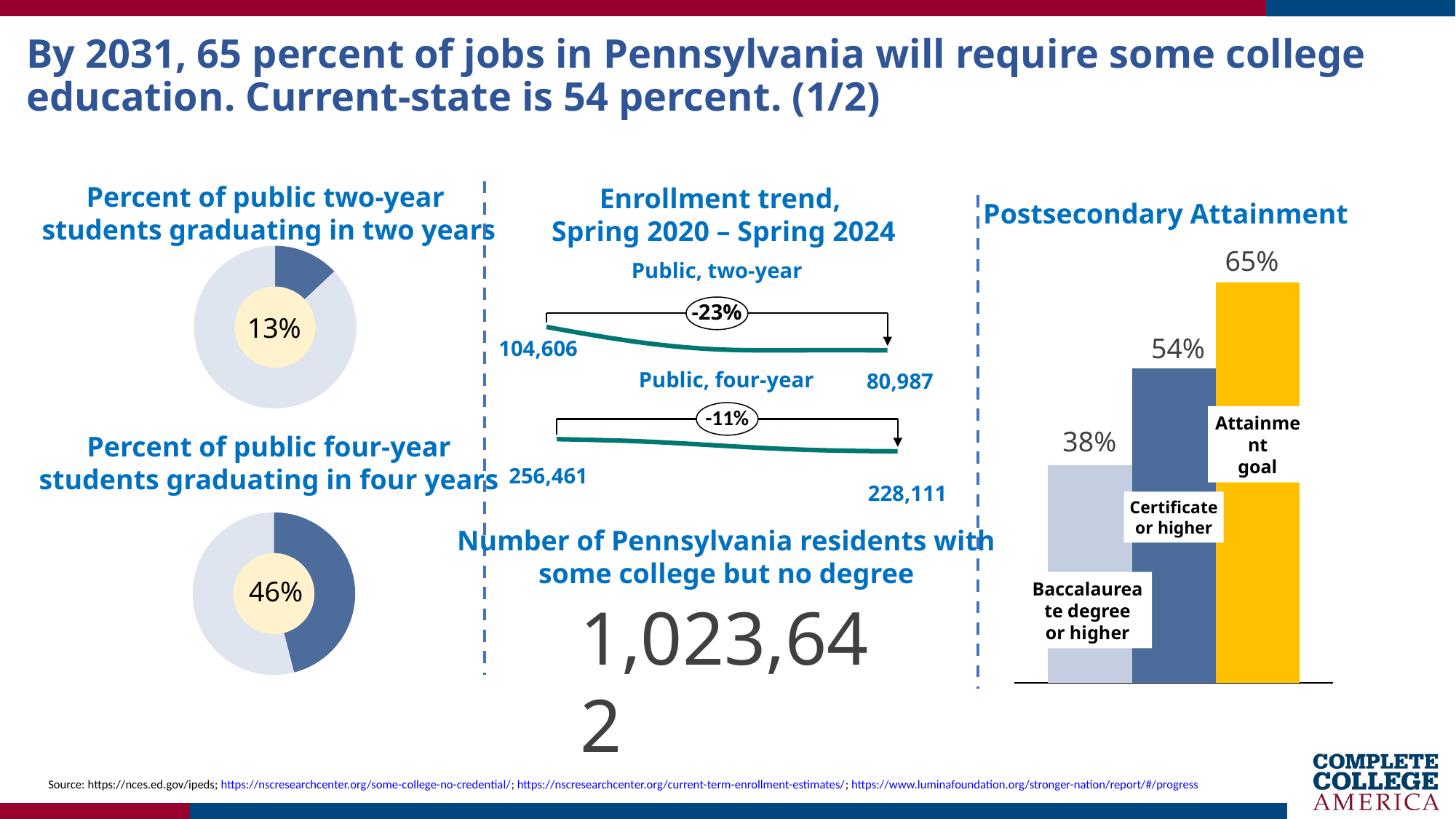
In the 'Postsecondary Attainment' chart, how many bars are shown? 3 In the 'Percent of public two-year students graduating in two years' chart, what percentage is shown? 13% In the 'Postsecondary Attainment' chart, which category has the highest value? Attainment goal In the 'Enrollment trend, Spring 2020 – Spring 2024' chart, by how much did Public, two-year enrollment decrease from 104,606 to 80,987? 23,619 In the 'Enrollment trend, Spring 2020 – Spring 2024' chart, what percentage change is shown for Public, two-year? -23% In the 'Enrollment trend, Spring 2020 – Spring 2024' chart, does Public, four-year enrollment rise or fall from Spring 2020 to Spring 2024? Fall In the 'Enrollment trend, Spring 2020 – Spring 2024' chart, what is the starting value for Public, two-year? 104,606 In the 'Postsecondary Attainment' chart, what is the value for Certificate or higher? 54% What kind of chart is used for 'Percent of public two-year students graduating in two years'? Donut (pie) chart In the 'Percent of public four-year students graduating in four years' chart, what percentage is shown? 46% In the 'Enrollment trend, Spring 2020 – Spring 2024' chart, what is the ending value for Public, four-year? 228,111 In the 'Postsecondary Attainment' chart, what is the difference between the Attainment goal and Certificate or higher? 11 percentage points